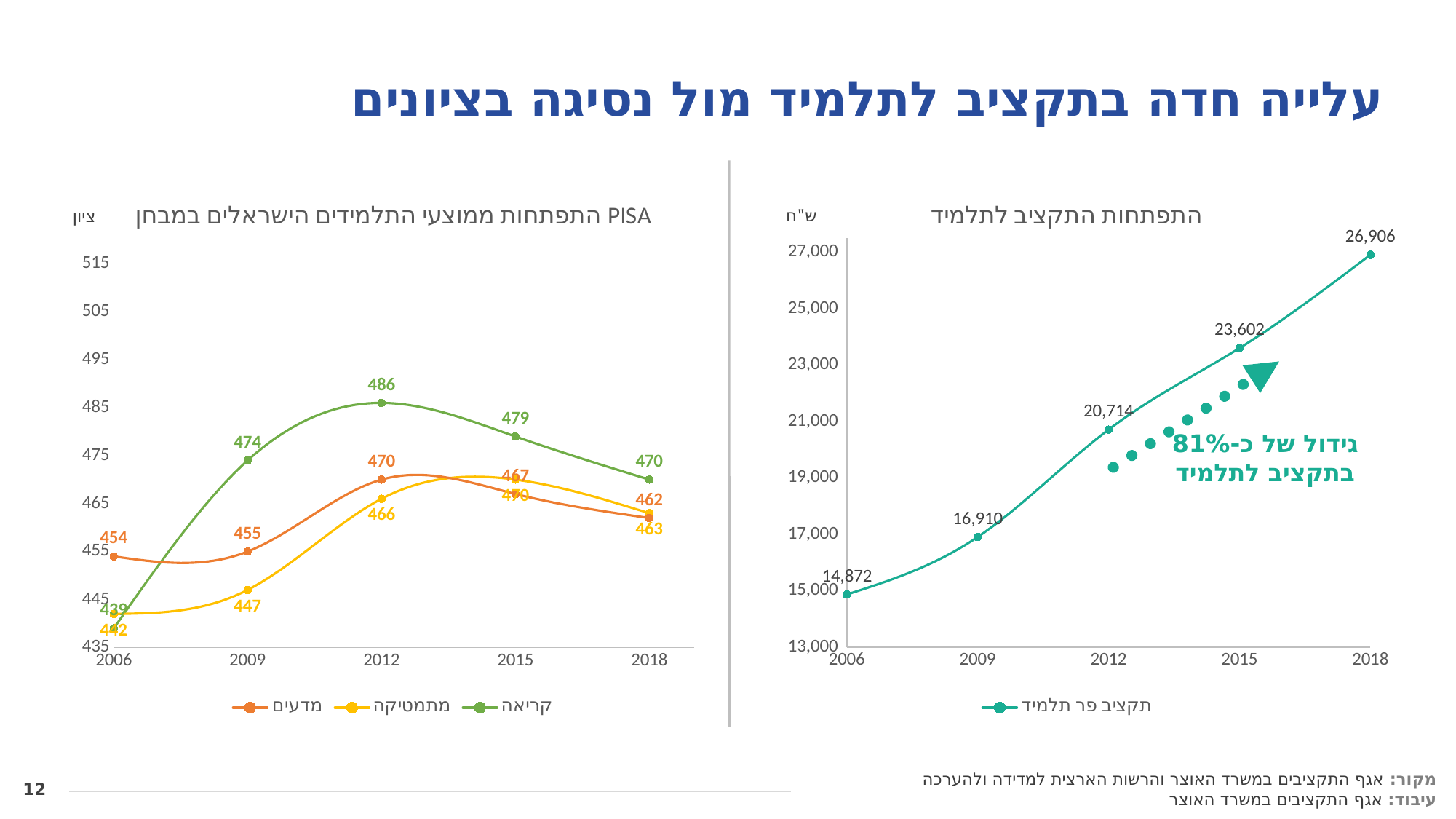
In the left chart (PISA), what is the value for מדעים in 2006? 454 In the right chart (התפתחות התקציב לתלמיד), what is the value for 2018? 26,906 In the right chart (התפתחות התקציב לתלמיד), what is the difference between the 2018 and 2006 values? 12,034 In the right chart (התפתחות התקציב לתלמיד), how many data points are plotted? 5 What kind of chart is the right chart (התפתחות התקציב לתלמיד)? line chart In the left chart (PISA), what is the value for קריאה in 2012? 486 In the left chart (PISA), how many series does the legend list? 3 In the left chart (PISA), in which year is the מתמטיקה series lowest? 2006 In the left chart (PISA), in which year is the קריאה series highest? 2012 In the right chart (התפתחות התקציב לתלמיד), do the values rise or fall from 2006 to 2018? rise In the left chart (PISA), what is the value for מתמטיקה in 2018? 463 In the right chart (התפתחות התקציב לתלמיד), what is the value for 2006? 14,872